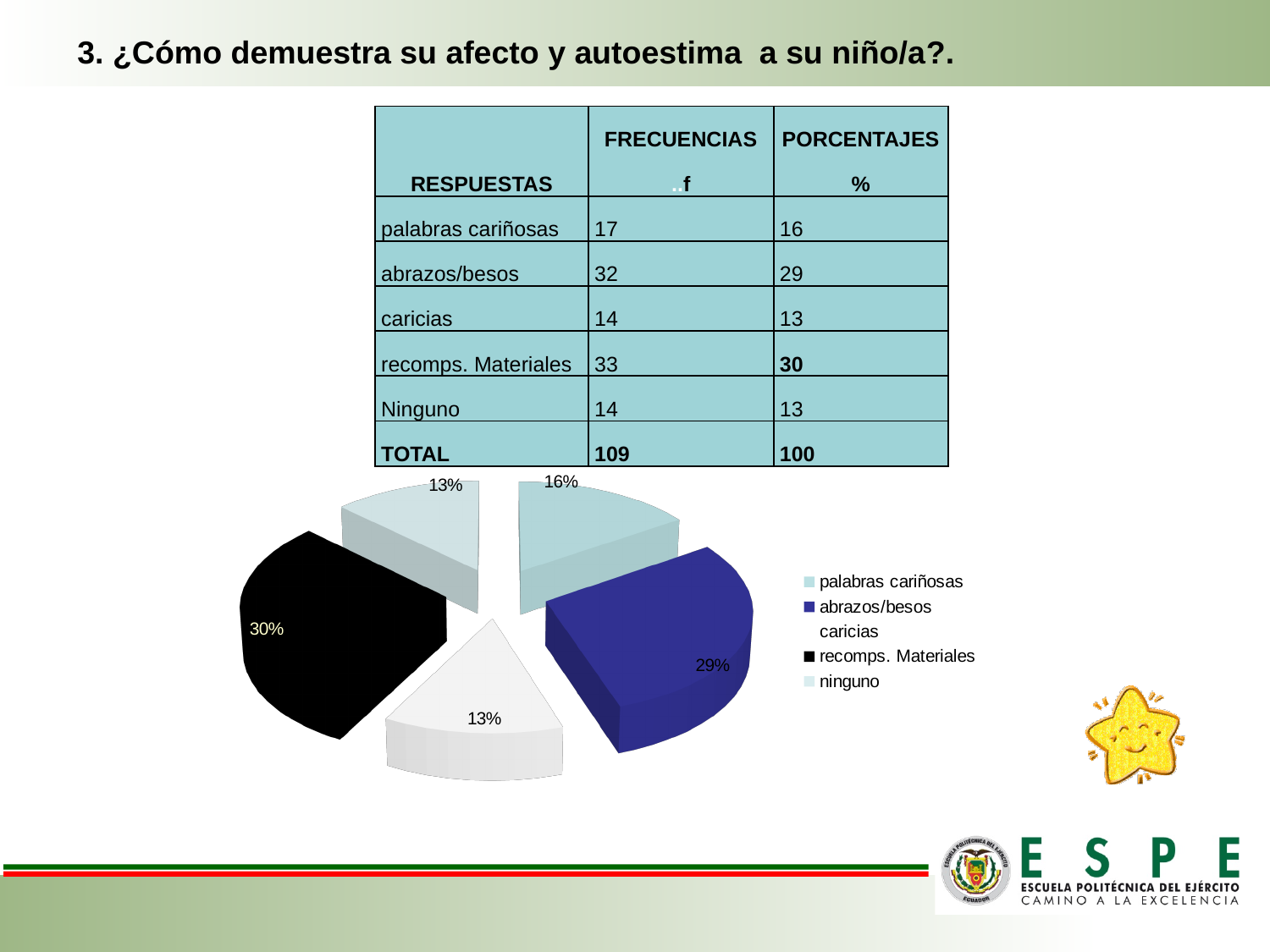
What percentage does the pie chart show for palabras cariñosas? 16% What colour is the recomps. Materiales slice in the pie chart? Black What kind of chart is shown on the slide? Pie chart What percentage does the pie chart show for caricias? 13% What percentage does the pie chart show for abrazos/besos? 29% What percentage does the pie chart show for recomps. Materiales? 30% By how many percentage points is the abrazos/besos slice larger than the palabras cariñosas slice? 13 percentage points What is the combined share of the palabras cariñosas and abrazos/besos slices? 45% What percentage does the pie chart show for ninguno? 13% Which slice is larger in the pie chart, palabras cariñosas or caricias? palabras cariñosas How many entries does the legend of the pie chart list? 5 How many slices does the pie chart have? 5